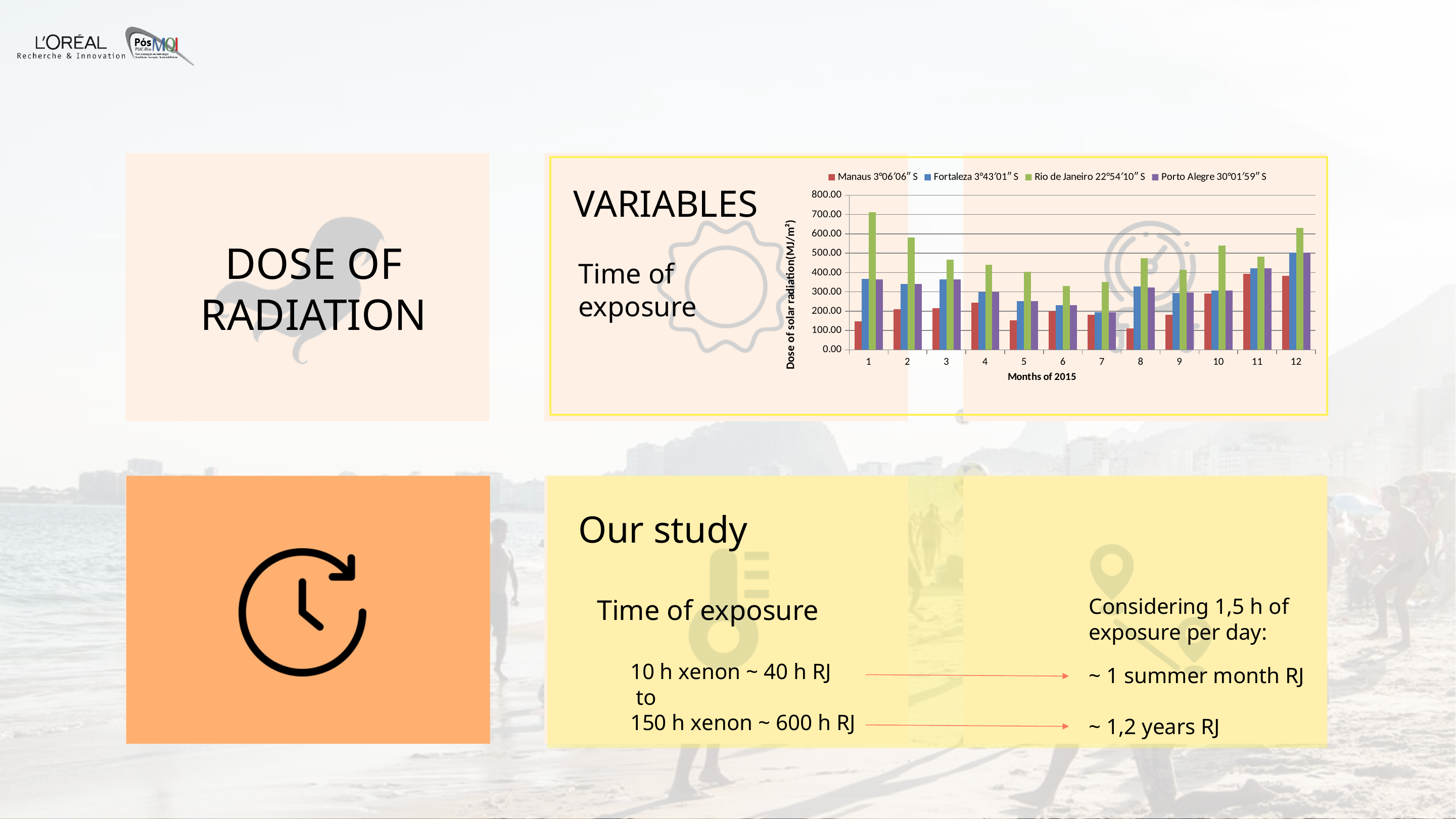
In which month is the Manaus bar lowest? 8 In month 1, which is larger: the Rio de Janeiro bar or the Manaus bar? Rio de Janeiro Which city has the highest bar in month 1? Rio de Janeiro What kind of chart is shown on the slide? bar chart Is the value for Rio de Janeiro in month 1 greater or less than 600? greater How many series does the chart legend list? 4 What is the label of the chart's y axis? Dose of solar radiation(MJ/m²) How many months are shown on the x axis of the chart? 12 In which month is the Rio de Janeiro bar highest? 1 Do the Rio de Janeiro values rise or fall from month 1 to month 6? fall Is the value for Manaus in month 8 greater or less than 200? less Is the value for Fortaleza in month 12 greater or less than 400? greater